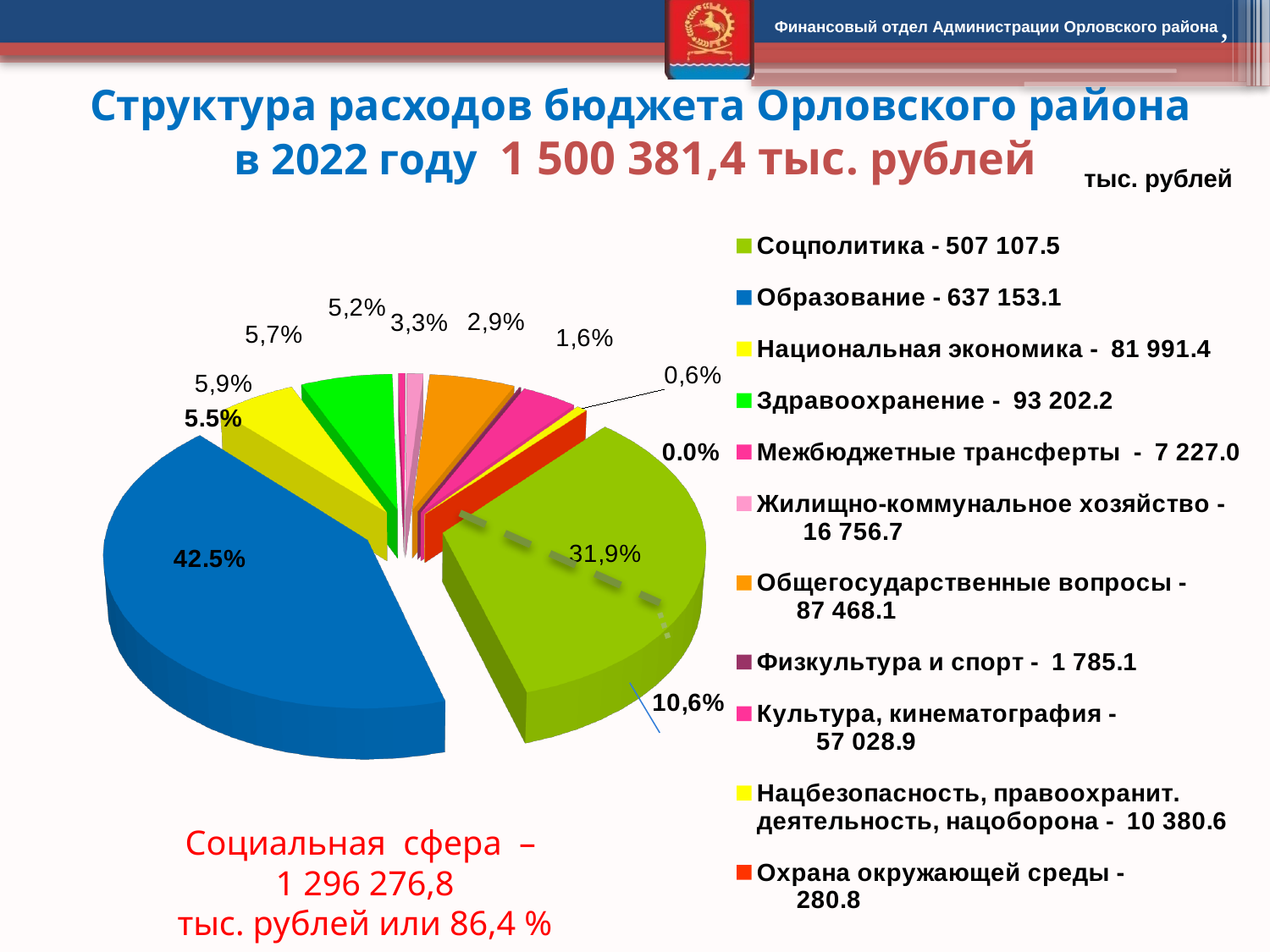
Which category has the smallest value in the pie chart? Охрана окружающей среды What value is shown in the legend for Физкультура и спорт? 1 785.1 What value is shown in the legend for Здравоохранение? 93 202.2 What value is shown in the legend for Культура, кинематография? 57 028.9 What type of chart is shown on the slide? pie chart What value is shown in the legend for Образование? 637 153.1 What is the difference between the values for Образование and Соцполитика? 130 045.6 What percentage share is labelled on the largest (blue) slice of the pie chart? 42.5% Which category has the largest value in the pie chart? Образование How many categories does the legend of the pie chart list? 11 Which is larger, Национальная экономика or Общегосударственные вопросы? Общегосударственные вопросы Which is larger, Соцполитика or Образование? Образование